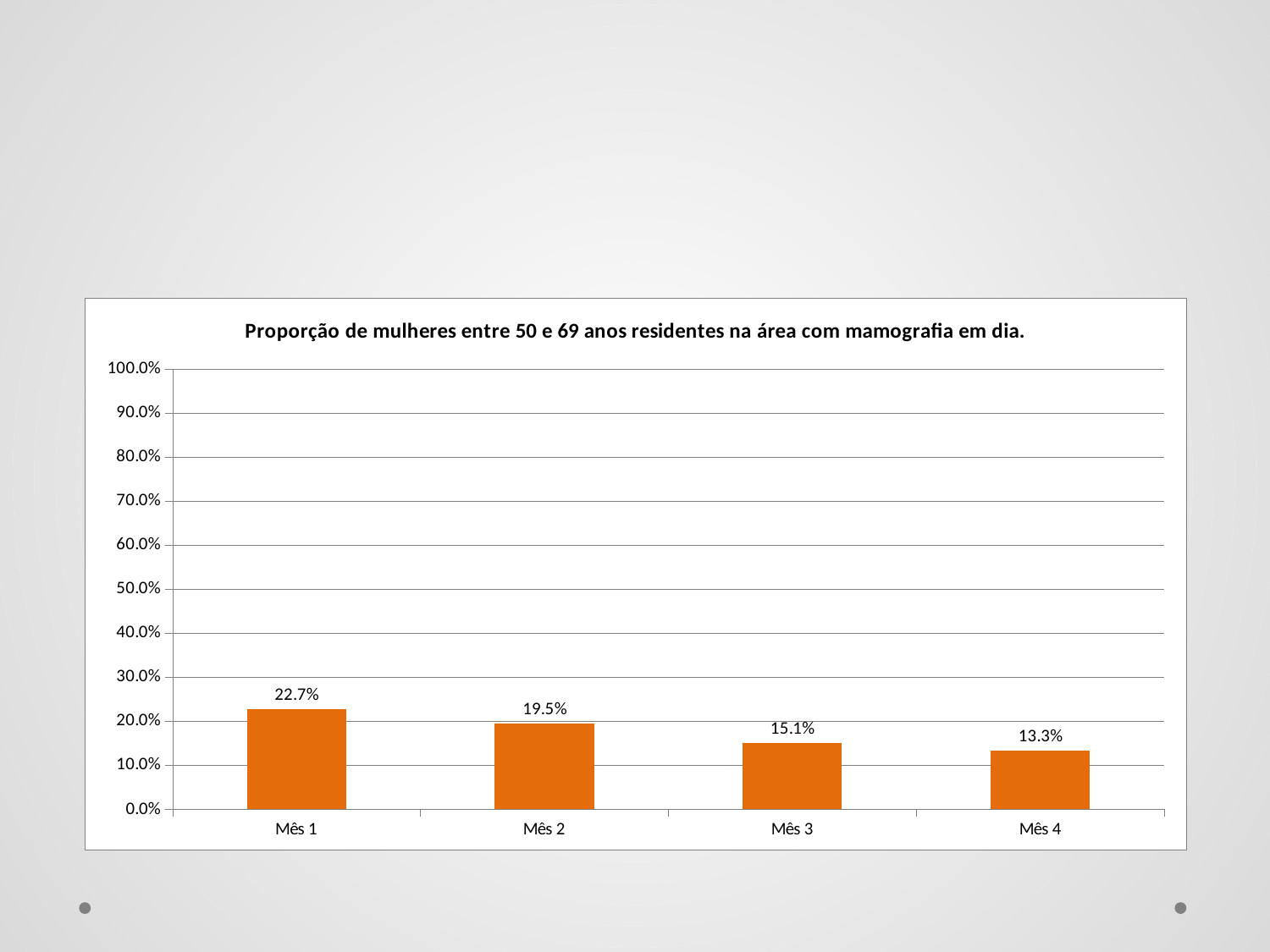
Which is larger, the value for Mês 2 or the value for Mês 3? Mês 2 What is the value for Mês 4? 13.3% What is the value for Mês 3? 15.1% Which month has the highest value? Mês 1 What kind of chart is shown on the slide? Bar chart Is the value for Mês 1 greater or less than 20.0%? greater How many months are shown on the x axis? 4 What is the value for Mês 1? 22.7% Which month has the lowest value? Mês 4 What is the difference between the values for Mês 1 and Mês 4? 9.4% What is the difference between the values for Mês 2 and Mês 3? 4.4% Do the values rise or fall from Mês 1 to Mês 4? Fall